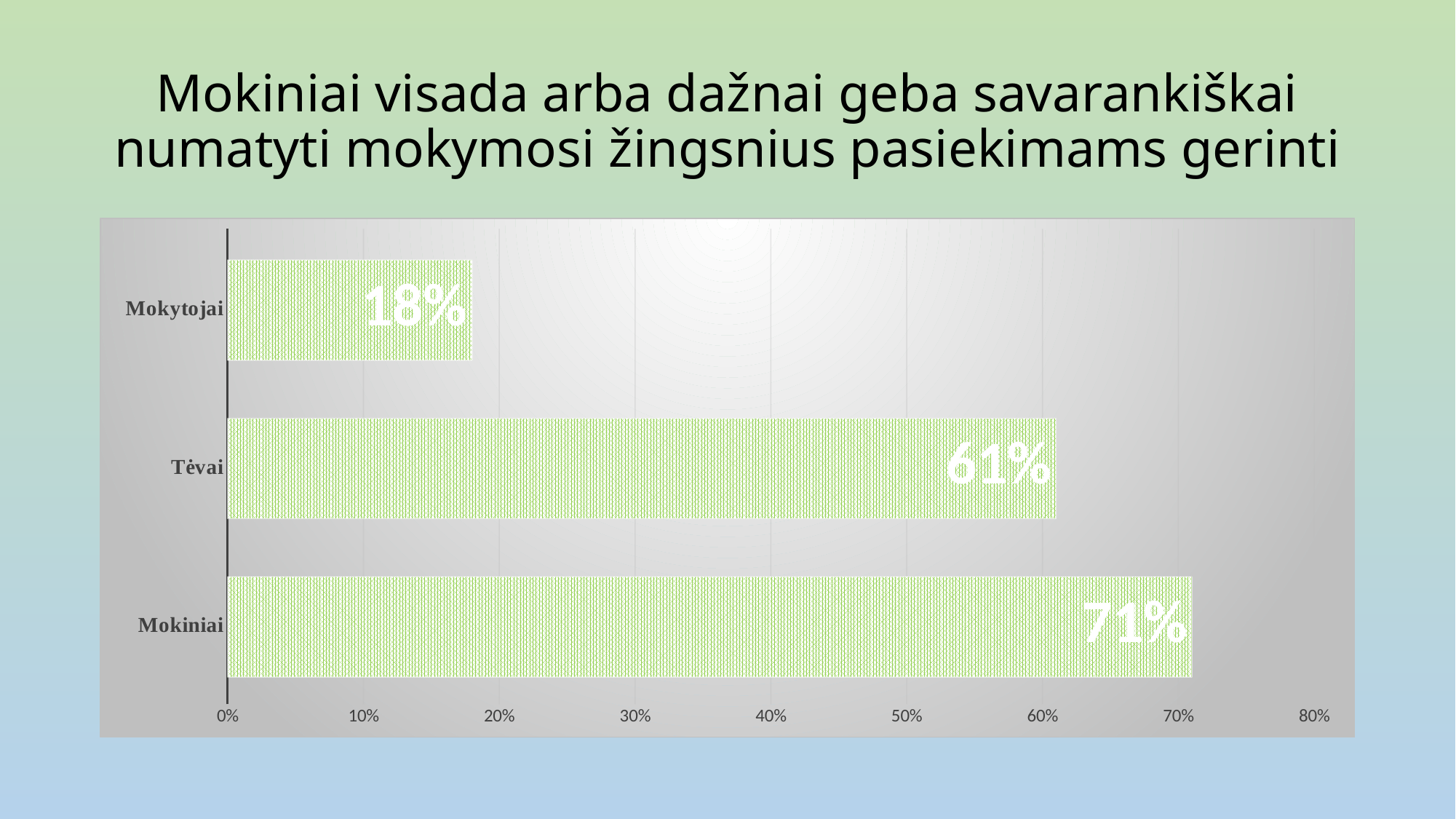
What is the value for Mokiniai? 71% What is the maximum value shown on the horizontal axis? 80% Is the value for Mokiniai greater or less than 60%? greater What kind of chart is shown on the slide? bar chart What is the difference between the values for Mokiniai and Tėvai? 10% What is the value for Tėvai? 61% Which is larger, the value for Tėvai or the value for Mokytojai? Tėvai What is the difference between the values for Tėvai and Mokytojai? 43% Which category has the highest value? Mokiniai How many categories are shown in the chart? 3 Which category has the lowest value? Mokytojai What is the value for Mokytojai? 18%